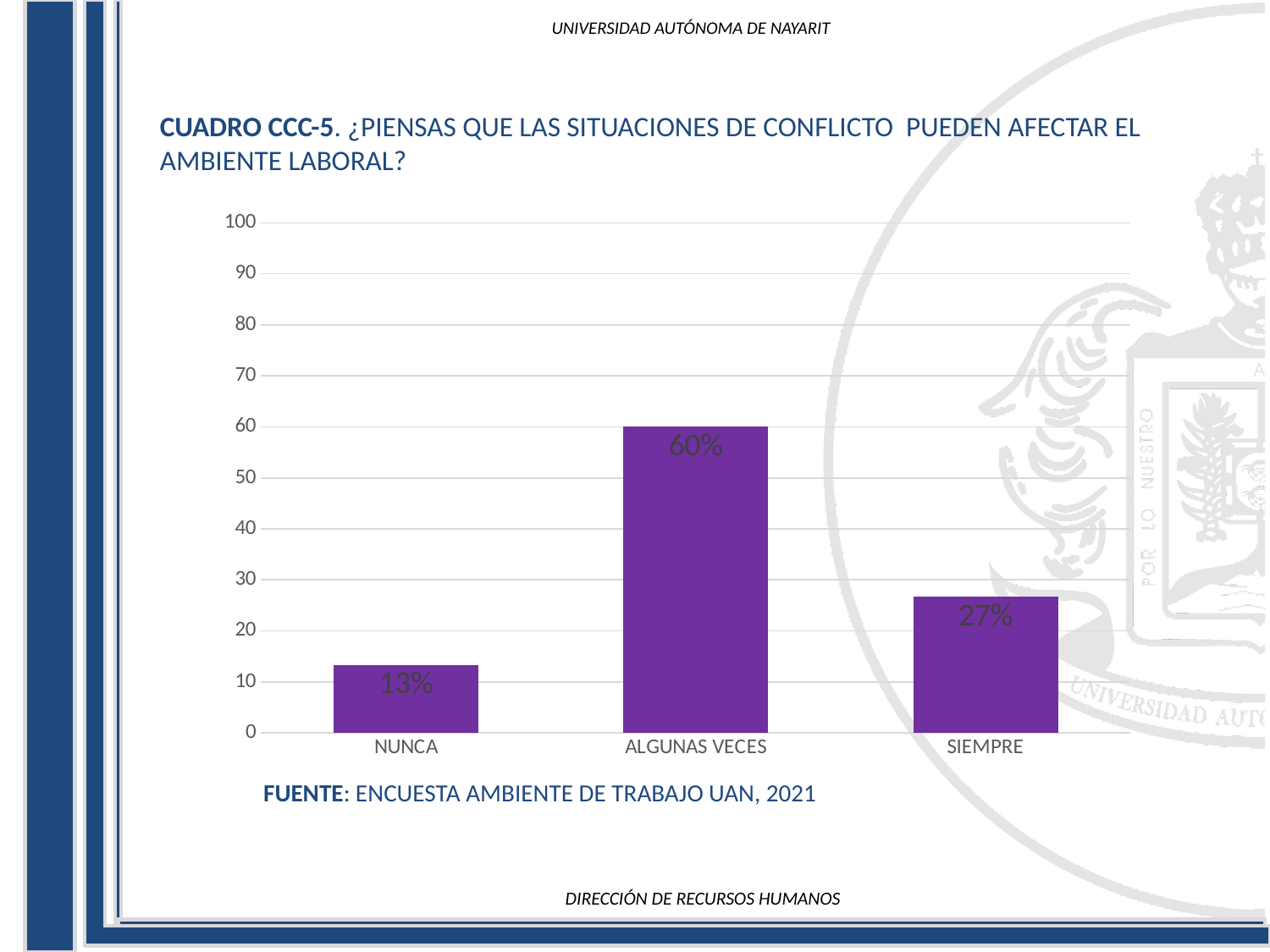
What is the value for SIEMPRE? 27% Is the value for SIEMPRE greater or less than 30? less What source is cited below the chart? ENCUESTA AMBIENTE DE TRABAJO UAN, 2021 Which category has the lowest value? NUNCA What is the value for NUNCA? 13% What is the value for ALGUNAS VECES? 60% What is the difference between the values for ALGUNAS VECES and SIEMPRE? 33% What is the difference between the values for SIEMPRE and NUNCA? 14% Which category has the highest value? ALGUNAS VECES Which is larger, the value for SIEMPRE or the value for NUNCA? SIEMPRE How many categories are shown on the x axis? 3 What kind of chart is shown on the slide? bar chart